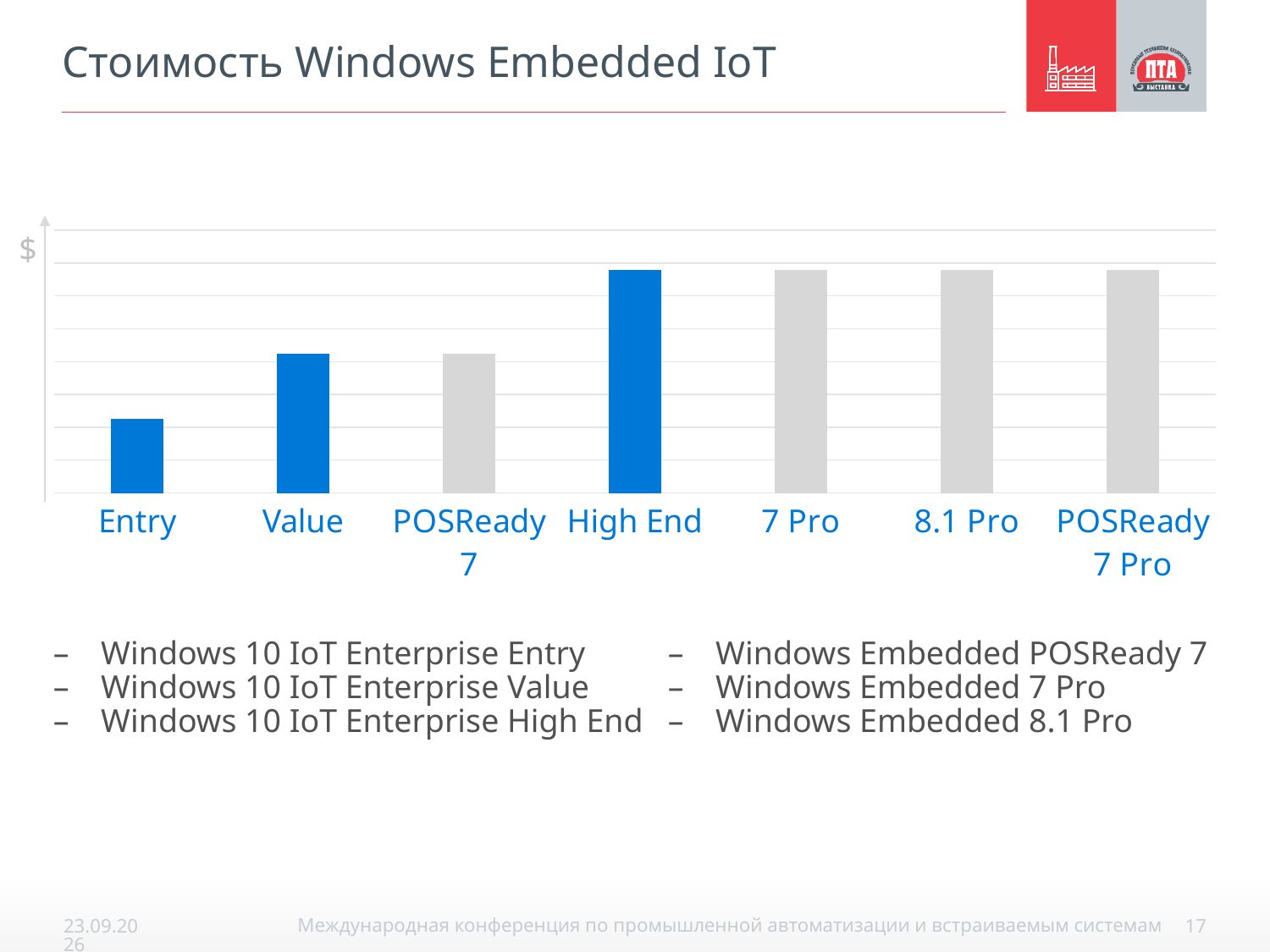
What symbol labels the vertical axis of the chart? $ Which bar is taller, Entry or 7 Pro? 7 Pro Which bar is taller, Entry or POSReady 7? POSReady 7 How many categories are shown on the x axis of the chart? 7 Which category has the lowest bar in the chart? Entry What is the title of the slide containing the chart? Стоимость Windows Embedded IoT Which bar is taller, POSReady 7 or 8.1 Pro? 8.1 Pro What kind of chart is shown on the slide? bar chart